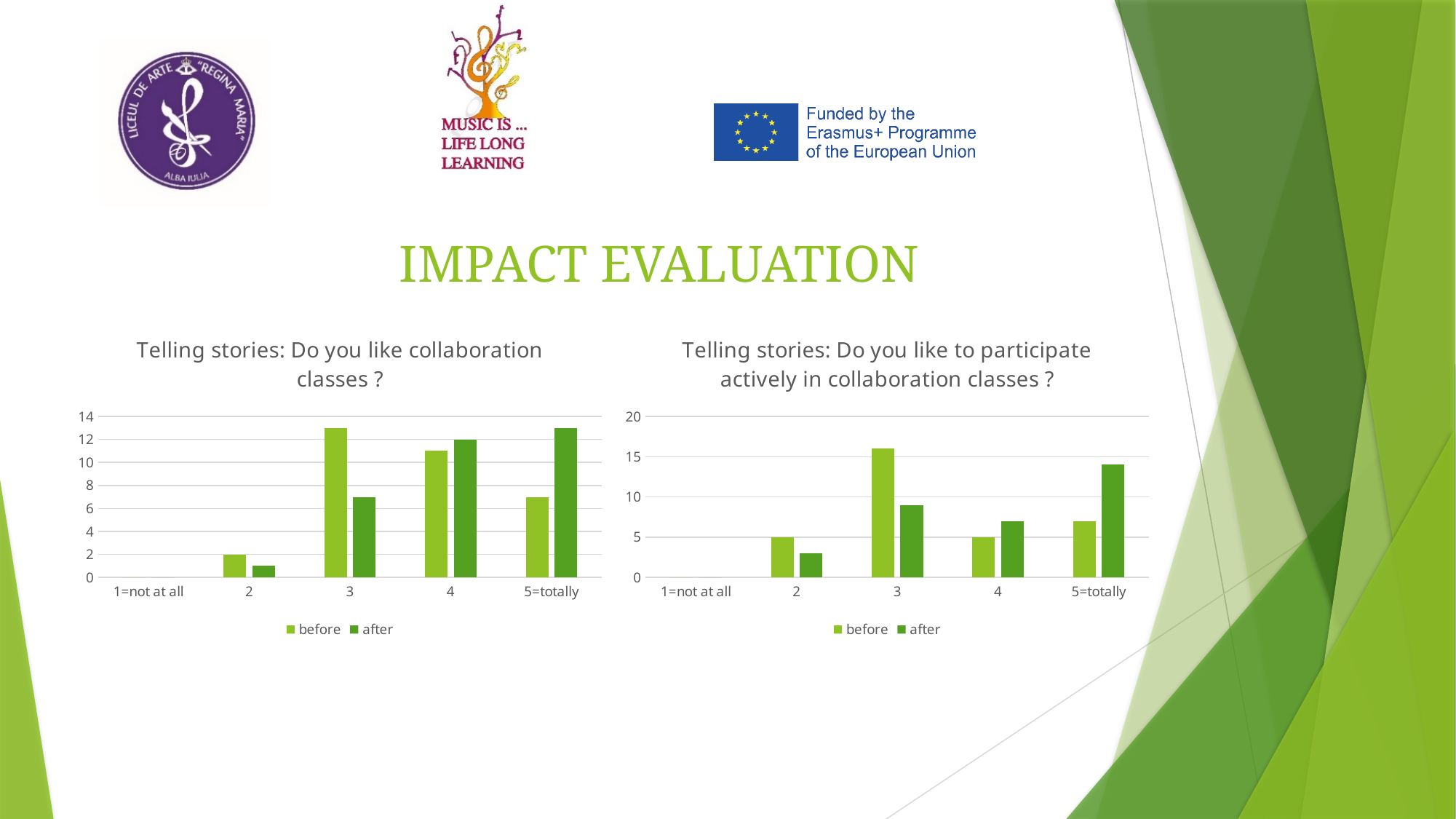
In the right chart (Do you like to participate actively in collaboration classes?), what is the 'before' value for category 2? 5 In the right chart (Do you like to participate actively in collaboration classes?), is the 'after' value for 5=totally greater or less than 10? greater In the right chart (Do you like to participate actively in collaboration classes?), is the 'before' value for category 3 greater or less than 15? greater How many series does the legend of the left chart list? 2 In the right chart (Do you like to participate actively in collaboration classes?), what is the 'before' value for category 4? 5 In the right chart (Do you like to participate actively in collaboration classes?), for 5=totally, which is larger: the 'before' value or the 'after' value? after What kind of chart is the right chart (Do you like to participate actively in collaboration classes?)? bar chart In the left chart (Do you like collaboration classes?), what is the 'after' value for category 4? 12 In the right chart (Do you like to participate actively in collaboration classes?), which category has the highest 'before' value? 3 In the left chart (Do you like collaboration classes?), which category has the highest 'after' value? 5=totally In the left chart (Do you like collaboration classes?), is the 'before' value for category 3 greater or less than 12? greater In the left chart (Do you like collaboration classes?), what is the 'before' value for category 2? 2